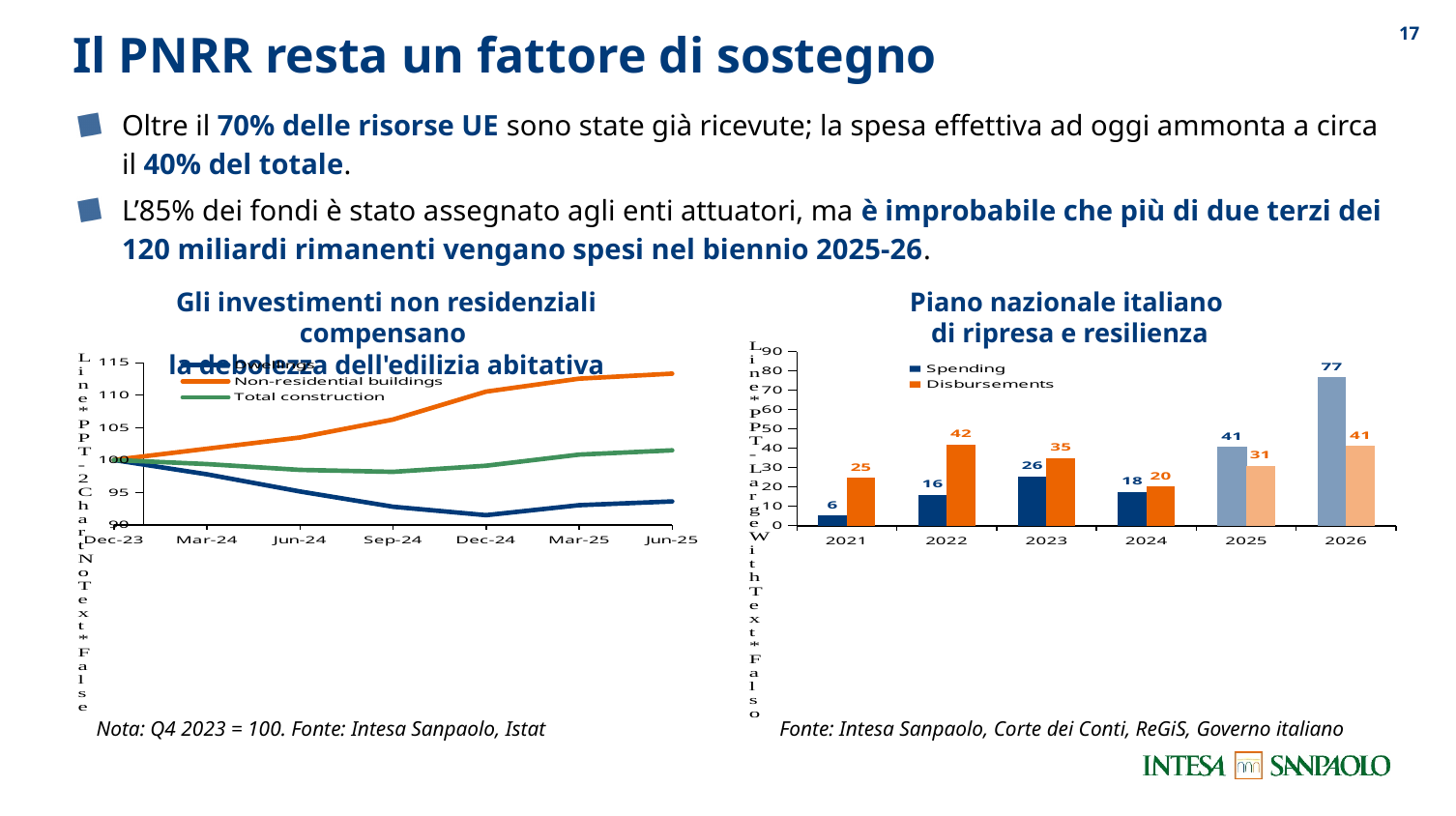
In the chart 'Piano nazionale italiano di ripresa e resilienza', what is the Disbursements value for 2022? 42 In the chart 'Piano nazionale italiano di ripresa e resilienza', which is larger in 2024, Spending or Disbursements? Disbursements In the left chart, is the value for Non-residential buildings at Jun-25 greater or less than 110? greater In the chart 'Piano nazionale italiano di ripresa e resilienza', how many series does the legend list? 2 In the chart 'Piano nazionale italiano di ripresa e resilienza', which year has the highest Spending value? 2026 In the chart 'Piano nazionale italiano di ripresa e resilienza', which year has the lowest Spending value? 2021 In the chart 'Piano nazionale italiano di ripresa e resilienza', how many years are shown on the x axis? 6 In the left chart, does the Non-residential buildings line rise or fall from Dec-23 to Jun-25? rise What kind of chart is 'Piano nazionale italiano di ripresa e resilienza'? bar chart In the chart 'Piano nazionale italiano di ripresa e resilienza', what is the difference between Spending and Disbursements in 2026? 36 In the chart 'Piano nazionale italiano di ripresa e resilienza', what is the Spending value for 2023? 26 What kind of chart is the left chart, 'Gli investimenti non residenziali compensano la debolezza dell'edilizia abitativa'? line chart